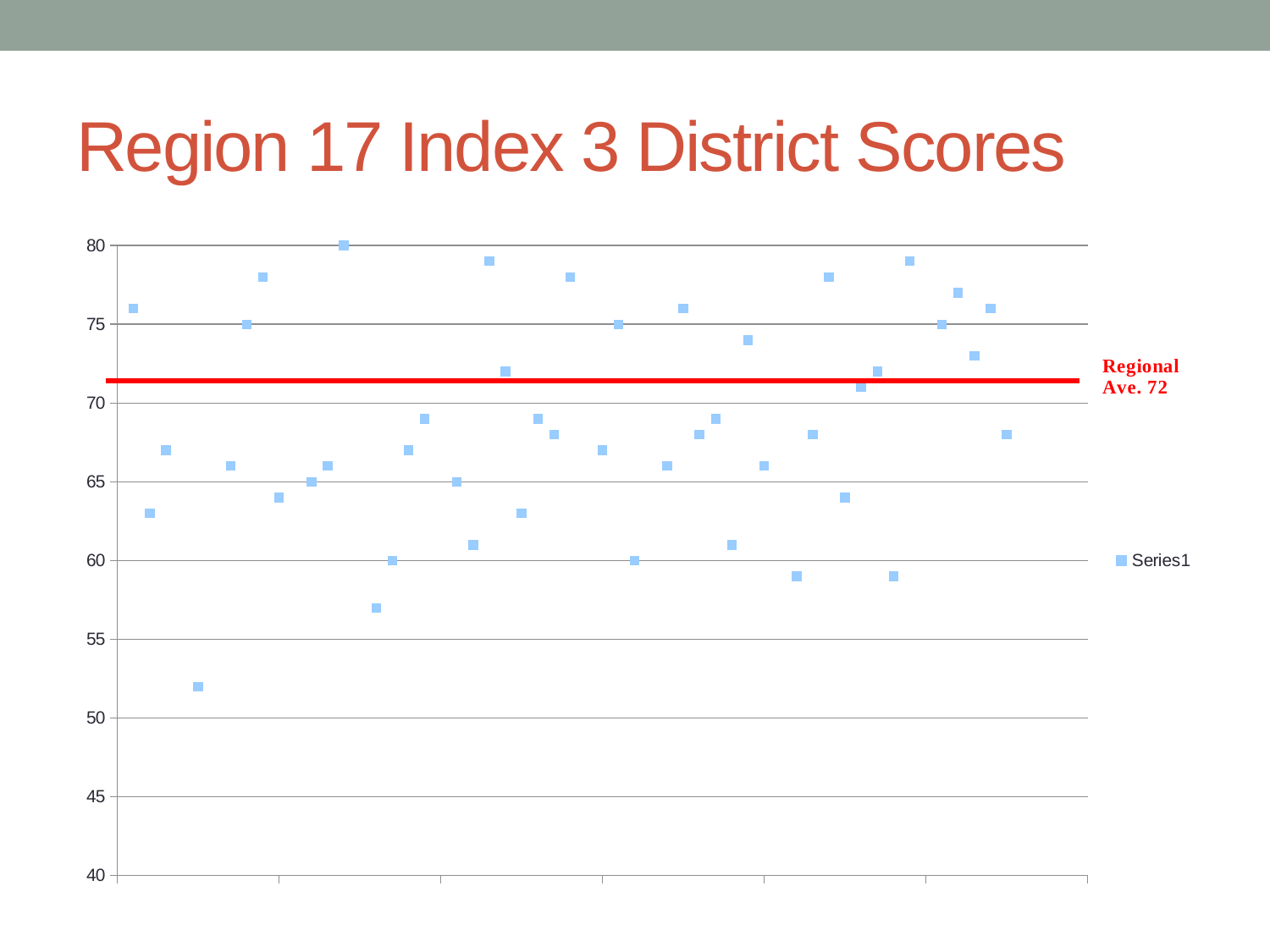
Is the highest plotted score greater or less than 75? greater How many series does the legend list? 1 What is the name of the series shown in the legend? Series1 What value does the red horizontal line across the chart represent? Regional Ave. 72 Is the lowest plotted score greater or less than 50? greater What kind of chart is shown on the slide? scatter chart Is the lowest plotted score greater or less than 55? less